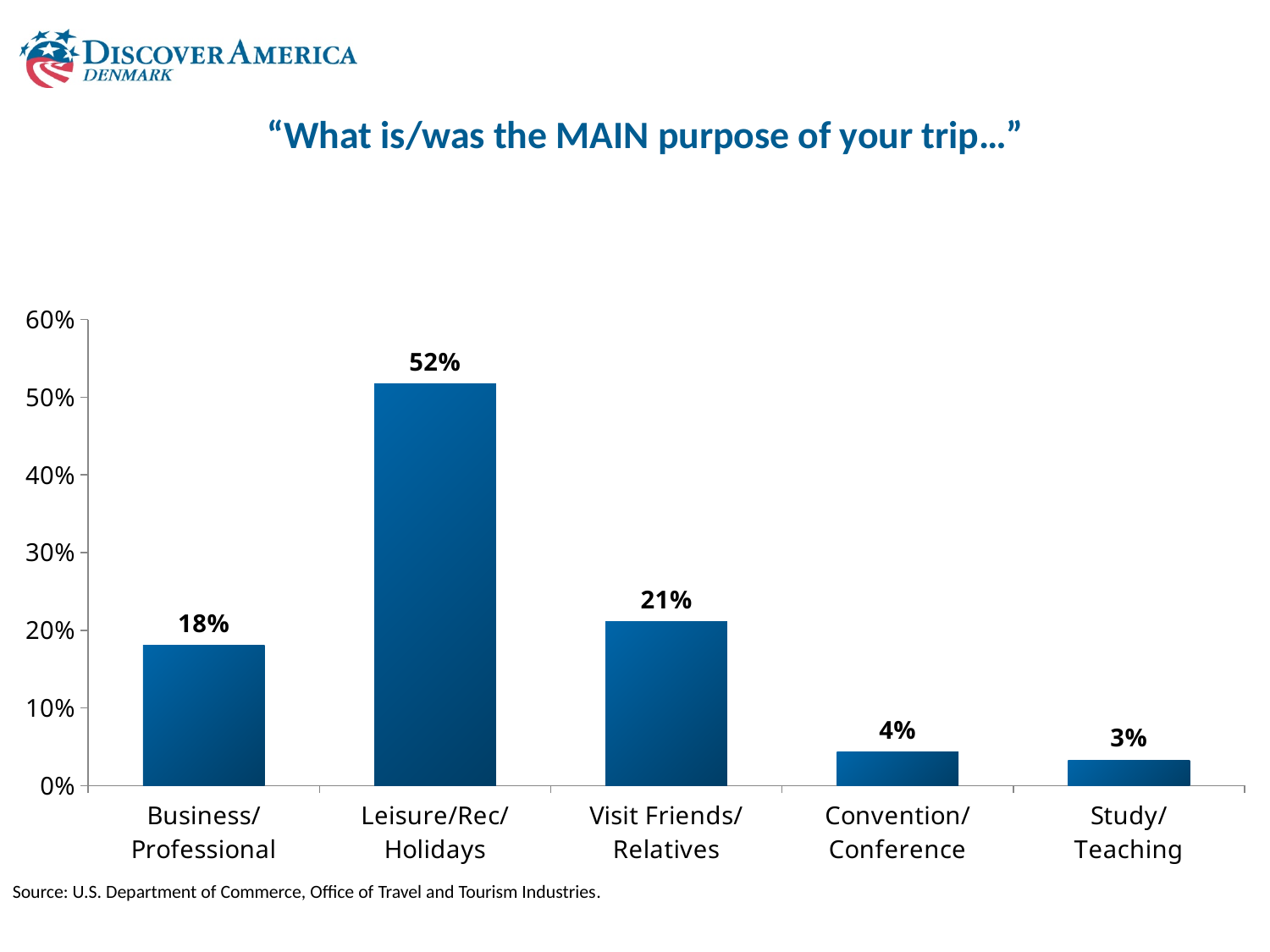
What is the value shown for Visit Friends/Relatives? 21% What percentage of respondents gave Leisure/Rec/Holidays as the main purpose of their trip? 52% What kind of chart is shown on the slide? bar chart What is the value shown for Study/Teaching? 3% Which trip purpose has the highest percentage? Leisure/Rec/Holidays What is the value shown for Business/Professional? 18% How many trip purpose categories are shown on the chart? 5 Which is larger, the value for Business/Professional or the value for Visit Friends/Relatives? Visit Friends/Relatives Is the value for Convention/Conference greater or less than 10%? less What is the title of the chart? "What is/was the MAIN purpose of your trip…" Which trip purpose has the lowest percentage? Study/Teaching What is the difference between the Leisure/Rec/Holidays value and the Visit Friends/Relatives value? 31%